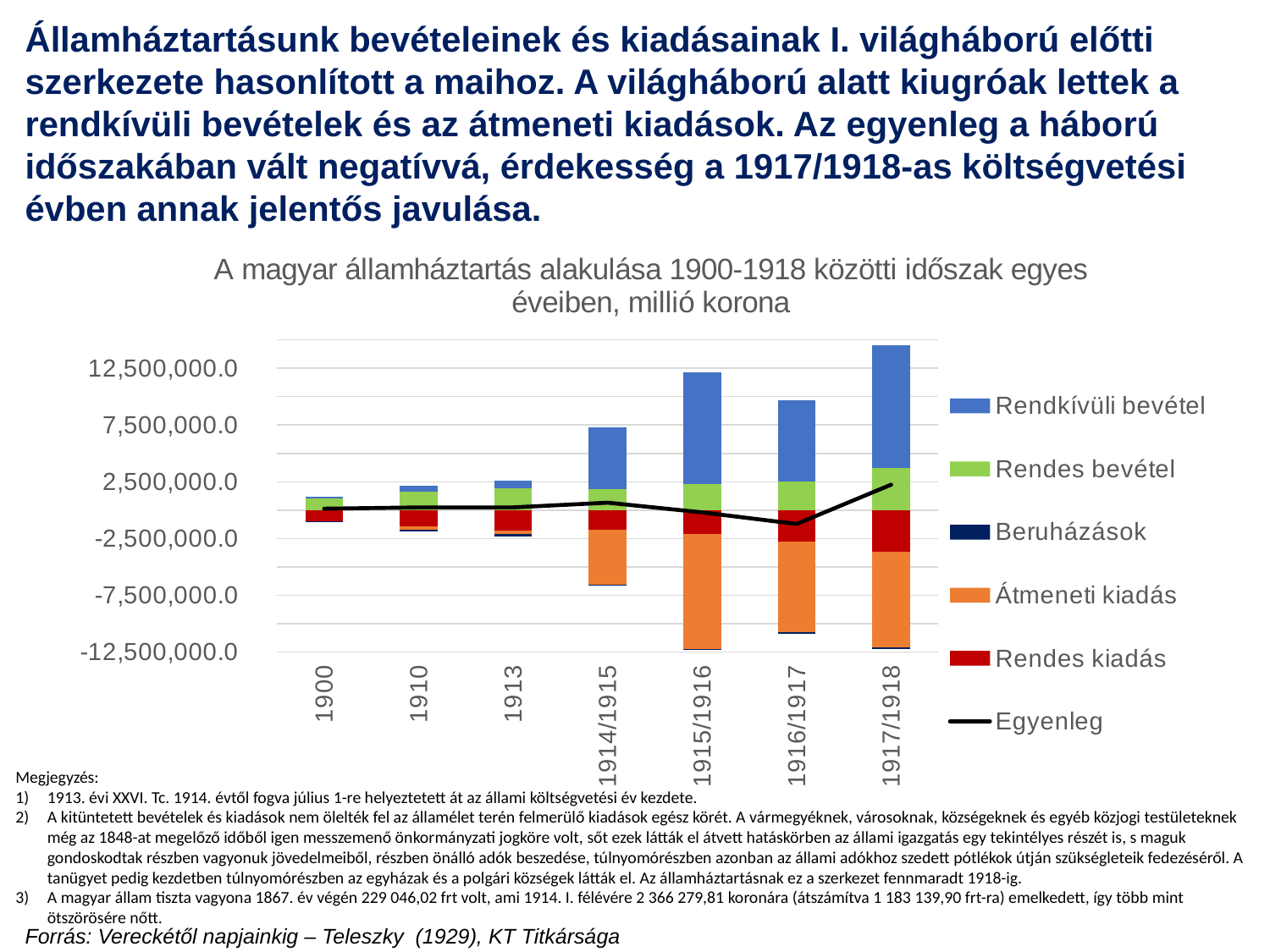
In which year does the Egyenleg line reach its highest value? 1917/1918 Does the Egyenleg line rise or fall between 1914/1915 and 1916/1917? Falls How many series does the chart legend list? 6 Which series in the chart is drawn as a line rather than bars? Egyenleg What kind of chart is shown on the slide? Stacked bar chart with a line Is the Rendkívüli bevétel segment larger in 1915/1916 or in 1916/1917? 1915/1916 Is the top of the positive stacked bar for 1900 greater or less than 2,500,000.0? less What is the title of the chart? A magyar államháztartás alakulása 1900-1918 közötti időszak egyes éveiben, millió korona Is the top of the positive stacked bar for 1917/1918 greater or less than 12,500,000.0? greater In which year does the Egyenleg line reach its lowest value? 1916/1917 Which year has the tallest positive stacked bar (revenues) in the chart? 1917/1918 How many categories (years) are shown on the x axis of the chart? 7